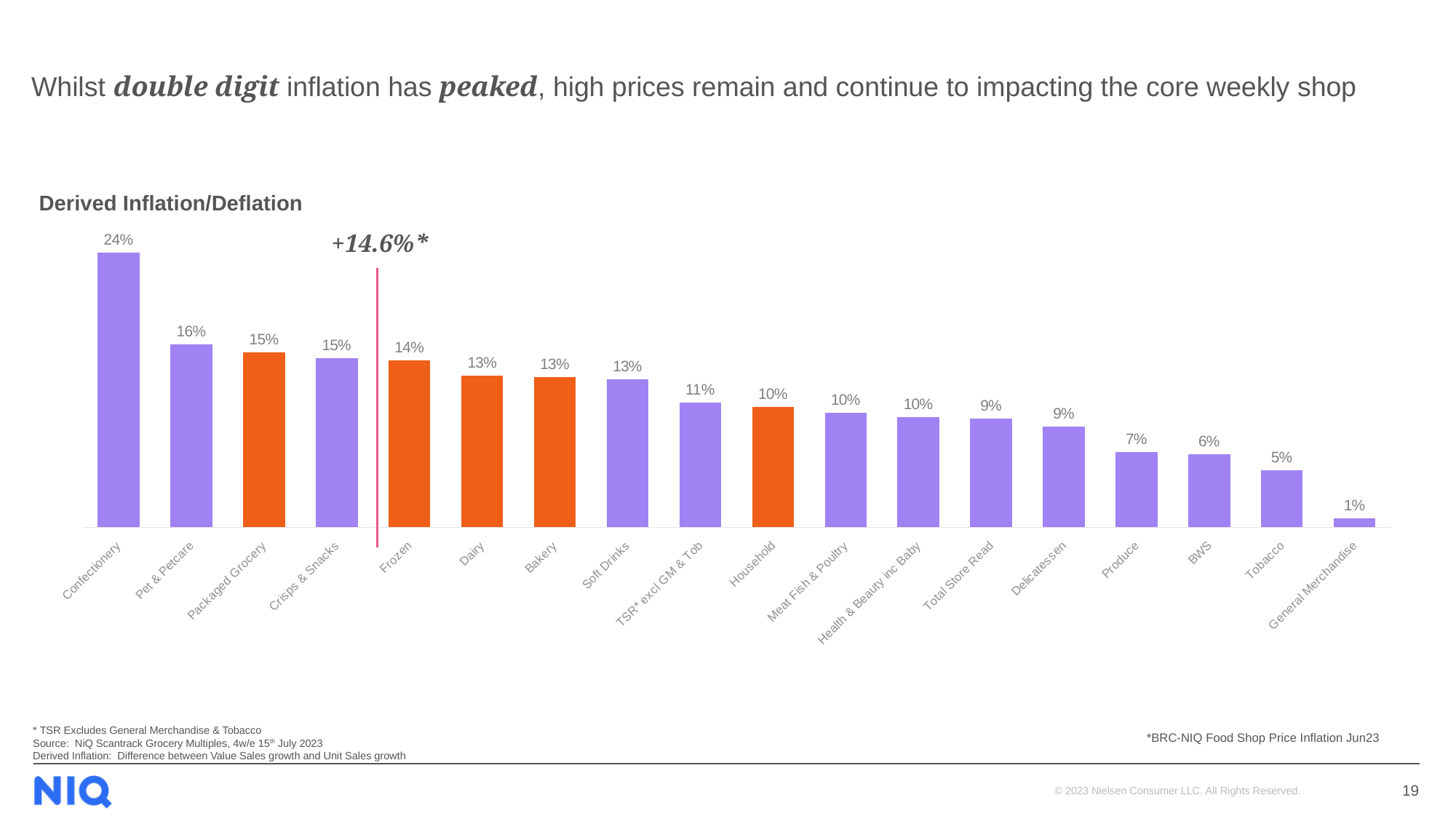
Which category has the lowest derived inflation? General Merchandise Which category has the highest derived inflation? Confectionery What is the difference between the derived inflation for Produce and General Merchandise? 6% What is the title of the chart? Derived Inflation/Deflation What is the derived inflation value for Frozen? 14% What kind of chart is shown on the slide? Bar chart What is the difference between the derived inflation for Confectionery and Pet & Petcare? 8% What is the derived inflation value for Tobacco? 5% What is the derived inflation value for Confectionery? 24% What is the derived inflation value for Household? 10% How many categories are shown in the chart? 18 Which has a higher derived inflation value, Soft Drinks or Delicatessen? Soft Drinks